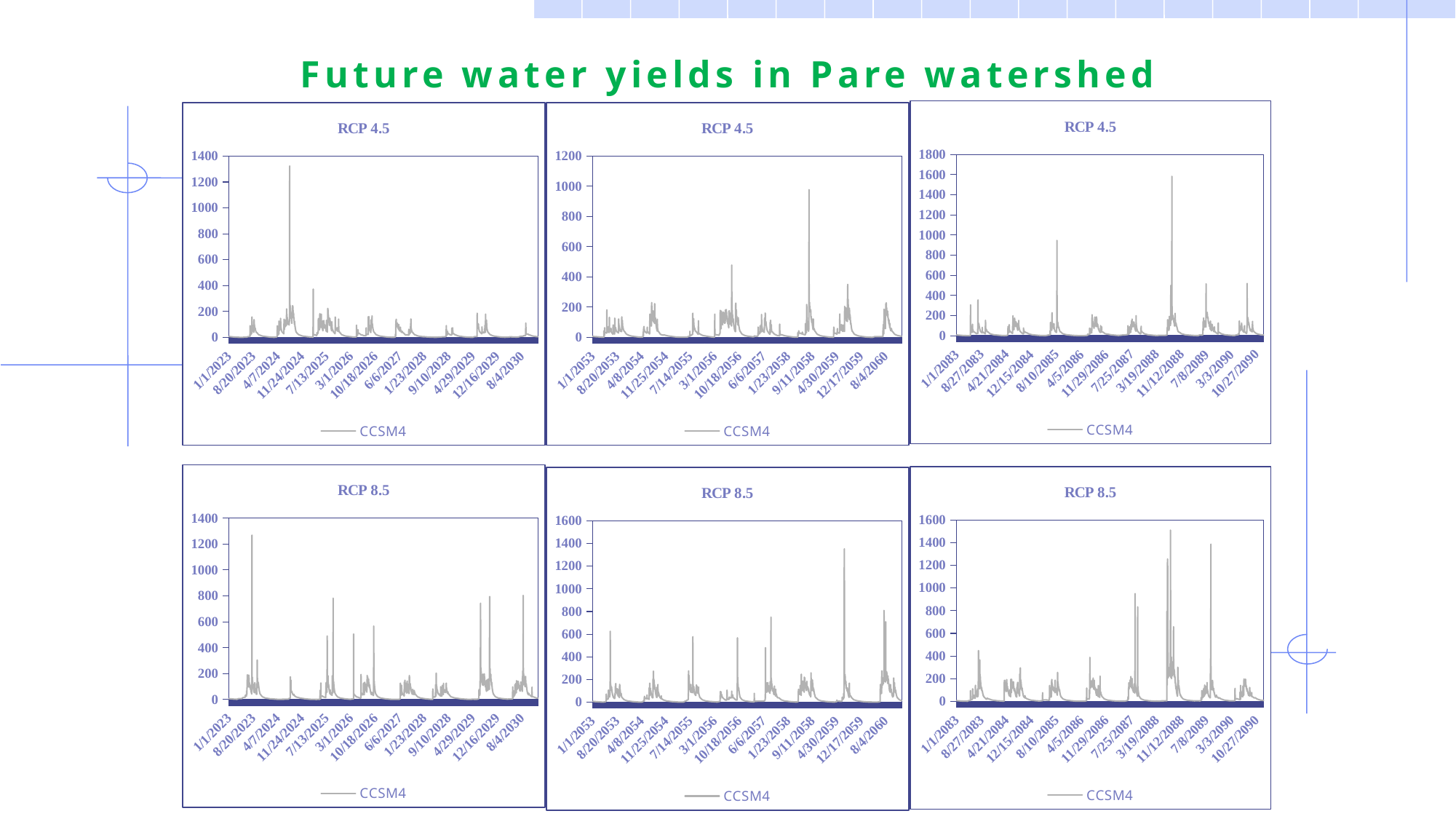
In the top-right RCP 4.5 chart (2083–2090), is the highest peak of the CCSM4 series greater or less than 1400? greater In the top-left RCP 4.5 chart (2023–2030), is the highest peak of the CCSM4 series greater or less than 1200? greater In the bottom-right RCP 8.5 chart (2083–2090), is the highest peak of the CCSM4 series greater or less than 1400? greater How many charts are shown on the slide? 6 What kind of chart is the top-left chart titled RCP 4.5? line chart What is the name of the series shown in the legend of the top-middle RCP 4.5 chart? CCSM4 What is the title of the slide above the charts? Future water yields in Pare watershed How many series does the legend of the bottom-left RCP 8.5 chart list? 1